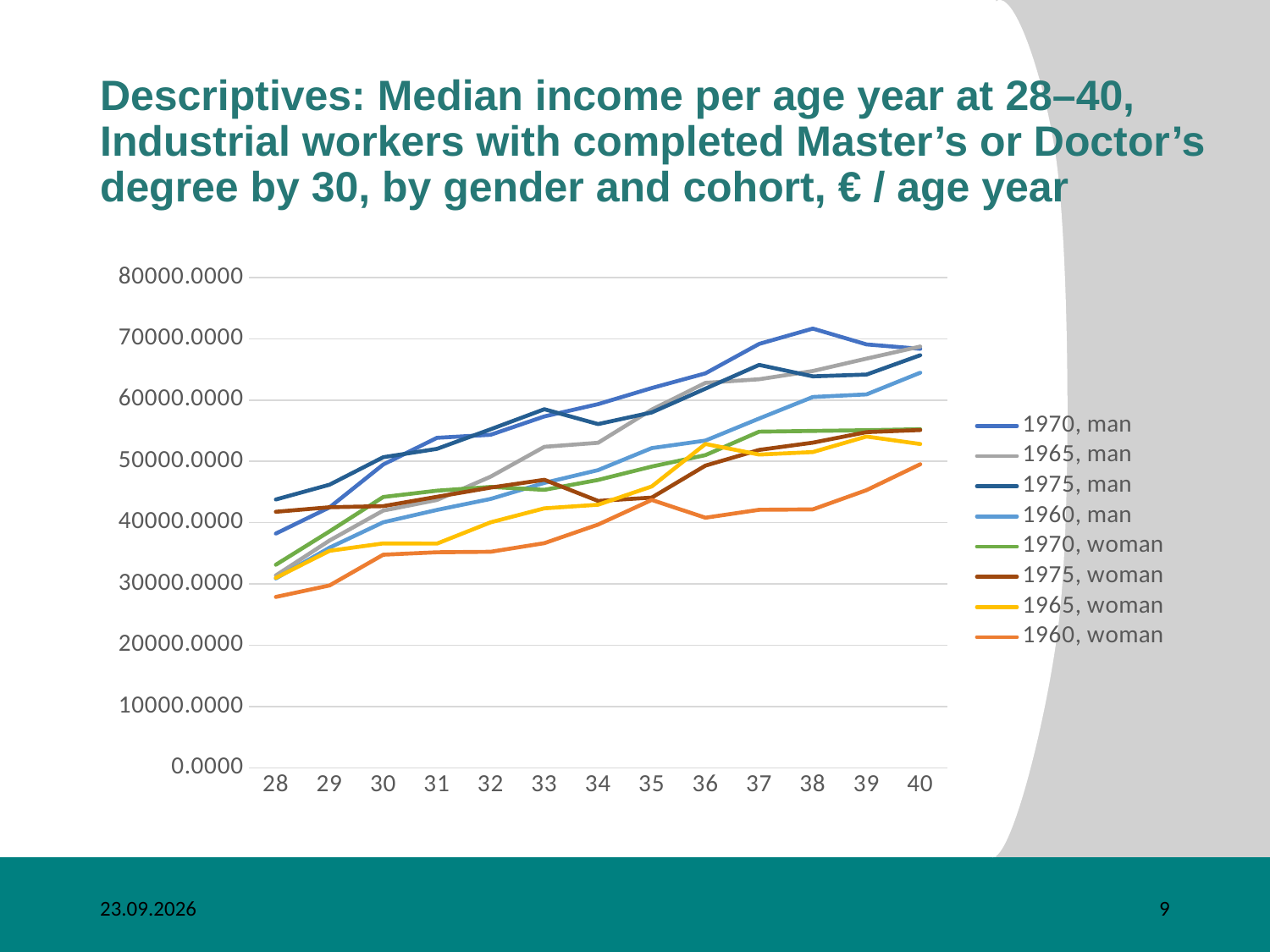
What kind of chart is shown on the slide? line chart At age 38, which is larger: the value for '1970, man' or the value for '1960, woman'? 1970, man How many series does the legend list? 8 Does the median income for the '1970, man' series generally rise or fall from age 28 to age 40? rise Is the value for '1960, woman' at age 28 greater or less than 30000? less Is the value for '1970, man' at age 38 greater or less than 70000? greater Is the value for '1975, man' at age 28 greater or less than 40000? greater How many age years are plotted along the x axis? 13 Which series has the highest value at age 38? 1970, man What is the first age year shown on the x axis? 28 Which series has the lowest value at age 28? 1960, woman